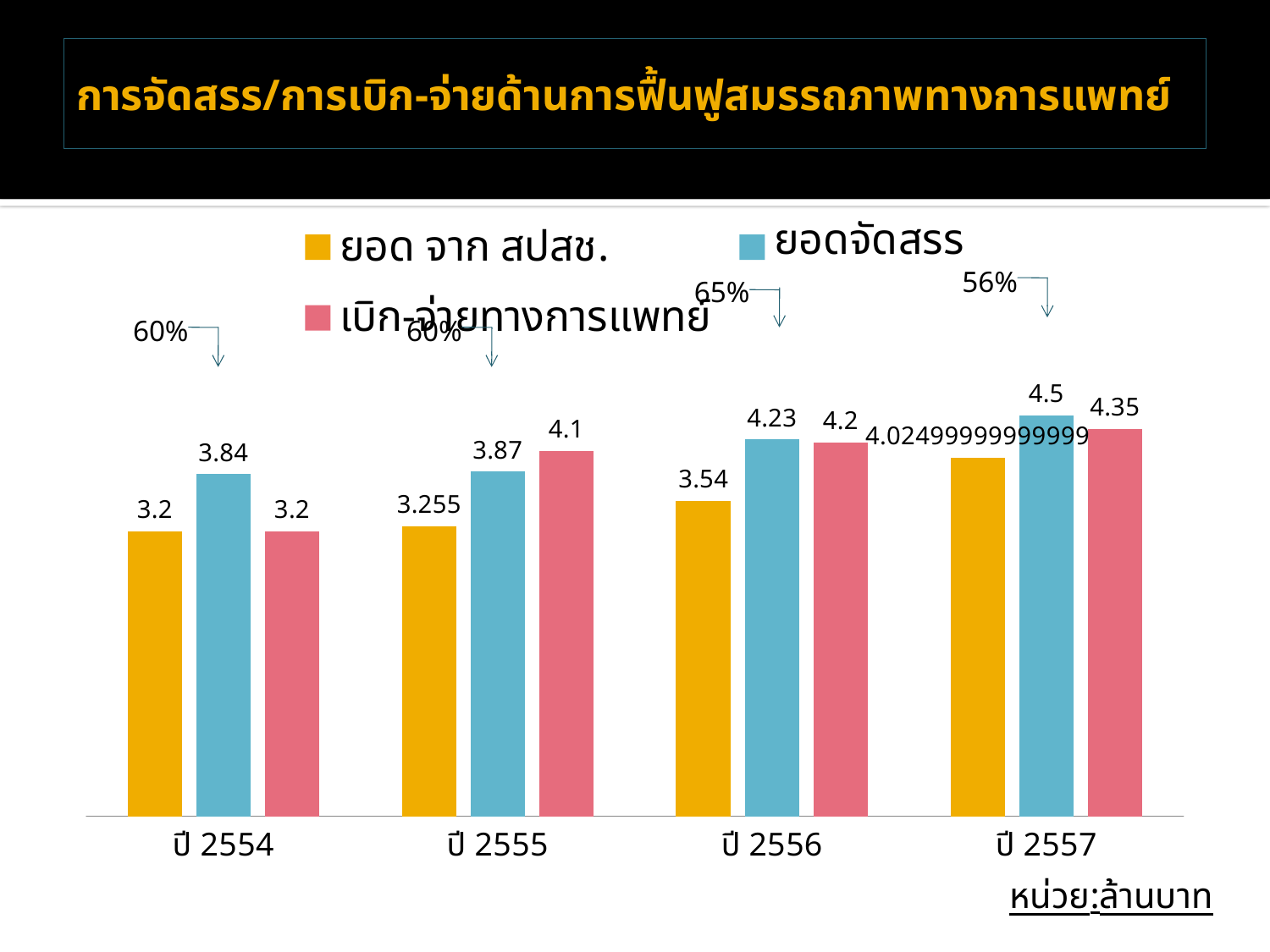
What is the value of ยอด จาก สปสช. for ปี 2555? 3.255 What type of chart is shown on the slide? bar chart What is the value of ยอดจัดสรร for ปี 2554? 3.84 What is the value of เบิก-จ่ายทางการแพทย์ for ปี 2556? 4.2 What is the difference between ยอดจัดสรร and ยอด จาก สปสช. for ปี 2554? 0.64 How many year categories are shown on the x axis? 4 In which year is ยอด จาก สปสช. the lowest? ปี 2554 Does the value of ยอดจัดสรร rise or fall from ปี 2554 to ปี 2557? rise How many series does the legend list? 3 For ปี 2555, which is larger: ยอดจัดสรร or เบิก-จ่ายทางการแพทย์? เบิก-จ่ายทางการแพทย์ What is the value of ยอดจัดสรร for ปี 2557? 4.5 In which year is ยอดจัดสรร the highest? ปี 2557